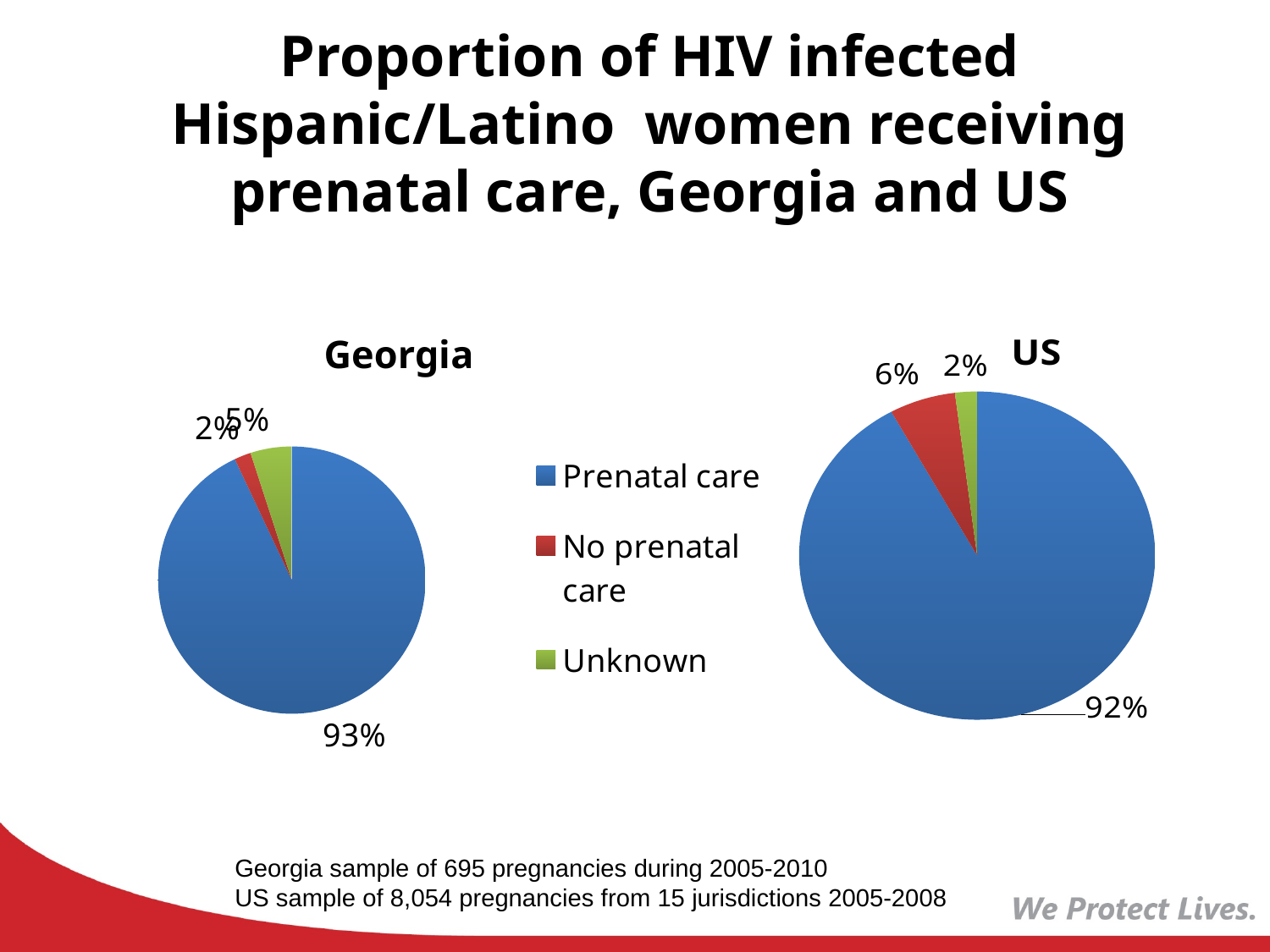
What is the difference between the Prenatal care share in Georgia and in the US? 1% In the US pie chart, what percentage of women received prenatal care? 92% In the Georgia pie chart, what percentage of women received prenatal care? 93% What colour represents No prenatal care in the pie charts? Red In the US pie chart, what percentage of women had no prenatal care? 6% How many categories does the legend list? 3 In the Georgia pie chart, which category has the largest slice? Prenatal care What kind of charts are shown on the slide? Pie charts Which has a larger Prenatal care share, the Georgia pie chart or the US pie chart? Georgia In the US pie chart, which category has the smallest slice? Unknown In the US pie chart, what percentage is labelled Unknown? 2% In the US pie chart, which category has the largest slice? Prenatal care